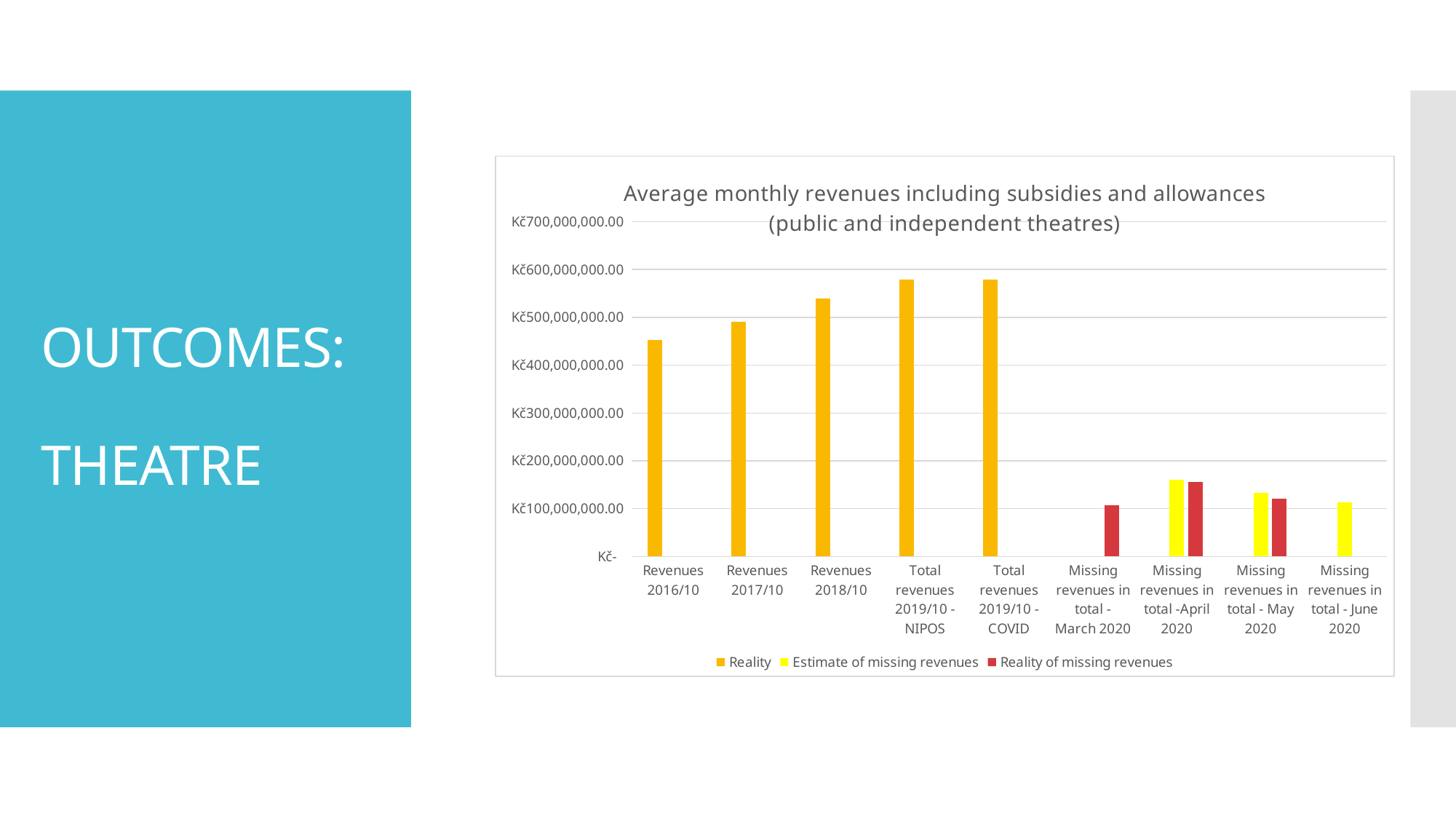
Which is larger, the Reality value for Revenues 2016/10 or for Revenues 2018/10? Revenues 2018/10 Is the value for Revenues 2016/10 greater or less than Kč400,000,000.00? greater What type of chart is shown on the slide? Bar chart Is the value for Revenues 2018/10 greater or less than Kč500,000,000.00? greater Which is larger, the Estimate of missing revenues for April 2020 or for June 2020? April 2020 Which colour represents the 'Estimate of missing revenues' series? Yellow How many series does the legend list? 3 Do the Reality bars rise or fall from Revenues 2016/10 to Total revenues 2019/10 - NIPOS? Rise What is the title of the chart? Average monthly revenues including subsidies and allowances (public and independent theatres) How many categories are shown on the x axis? 9 Is the value for Total revenues 2019/10 - NIPOS greater or less than Kč600,000,000.00? less